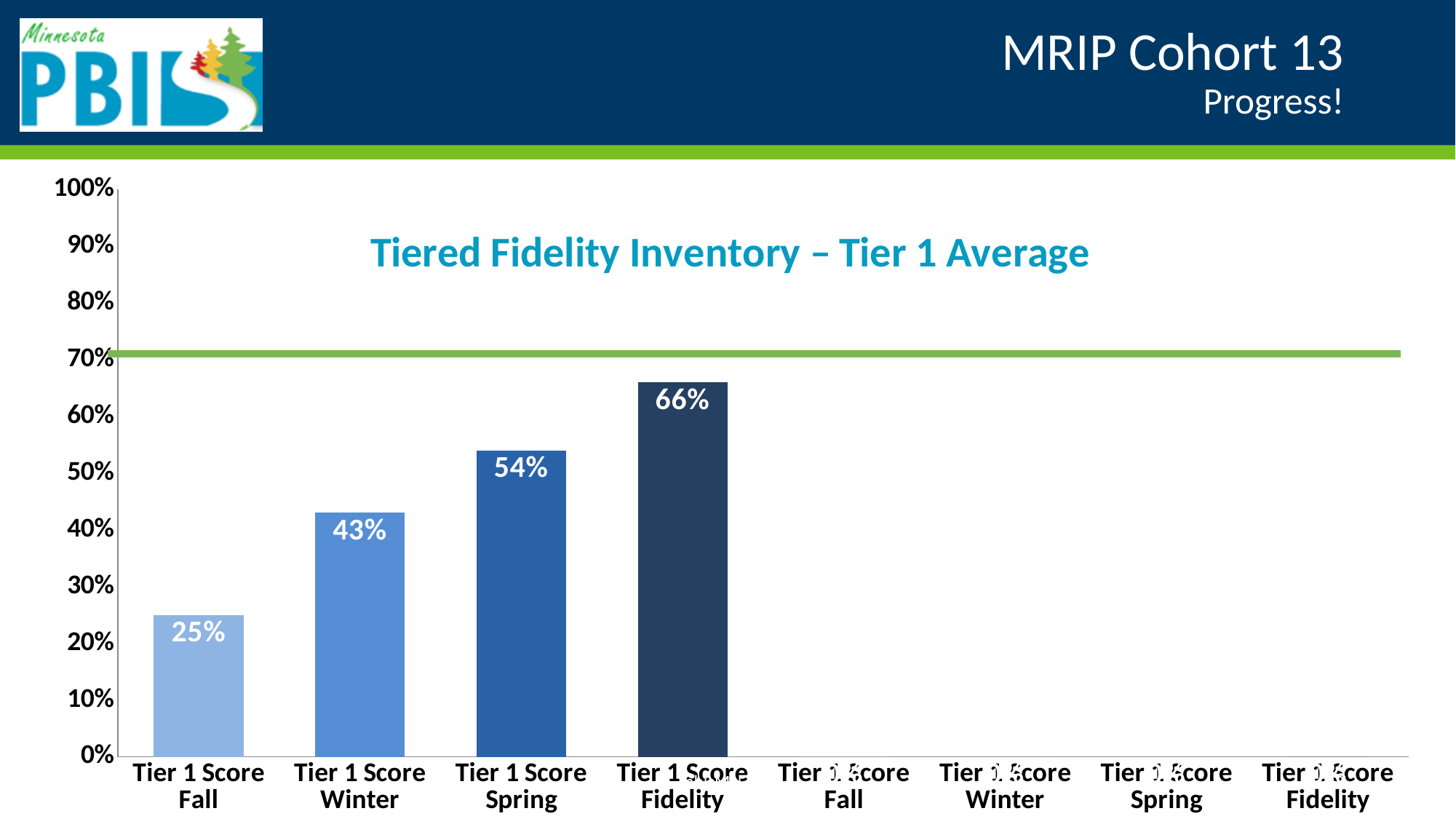
Do the bar values rise or fall from Tier 1 Score Fall to Tier 1 Score Fidelity? rise What kind of chart is shown on the slide? bar chart What is the value for Tier 1 Score Fall? 25% How many bars have a data label printed on them? 4 What is the difference between the Tier 1 Score Fidelity value and the Tier 1 Score Fall value? 41% Which is larger, the value for Tier 1 Score Winter or the value for Tier 1 Score Spring? Tier 1 Score Spring What is the value for Tier 1 Score Winter? 43% Is the value for Tier 1 Score Fidelity greater or less than 70%? less Which category has the highest value? Tier 1 Score Fidelity What is the value for Tier 1 Score Fidelity? 66% What is the value for Tier 1 Score Spring? 54% Which category has the lowest value? Tier 1 Score Fall